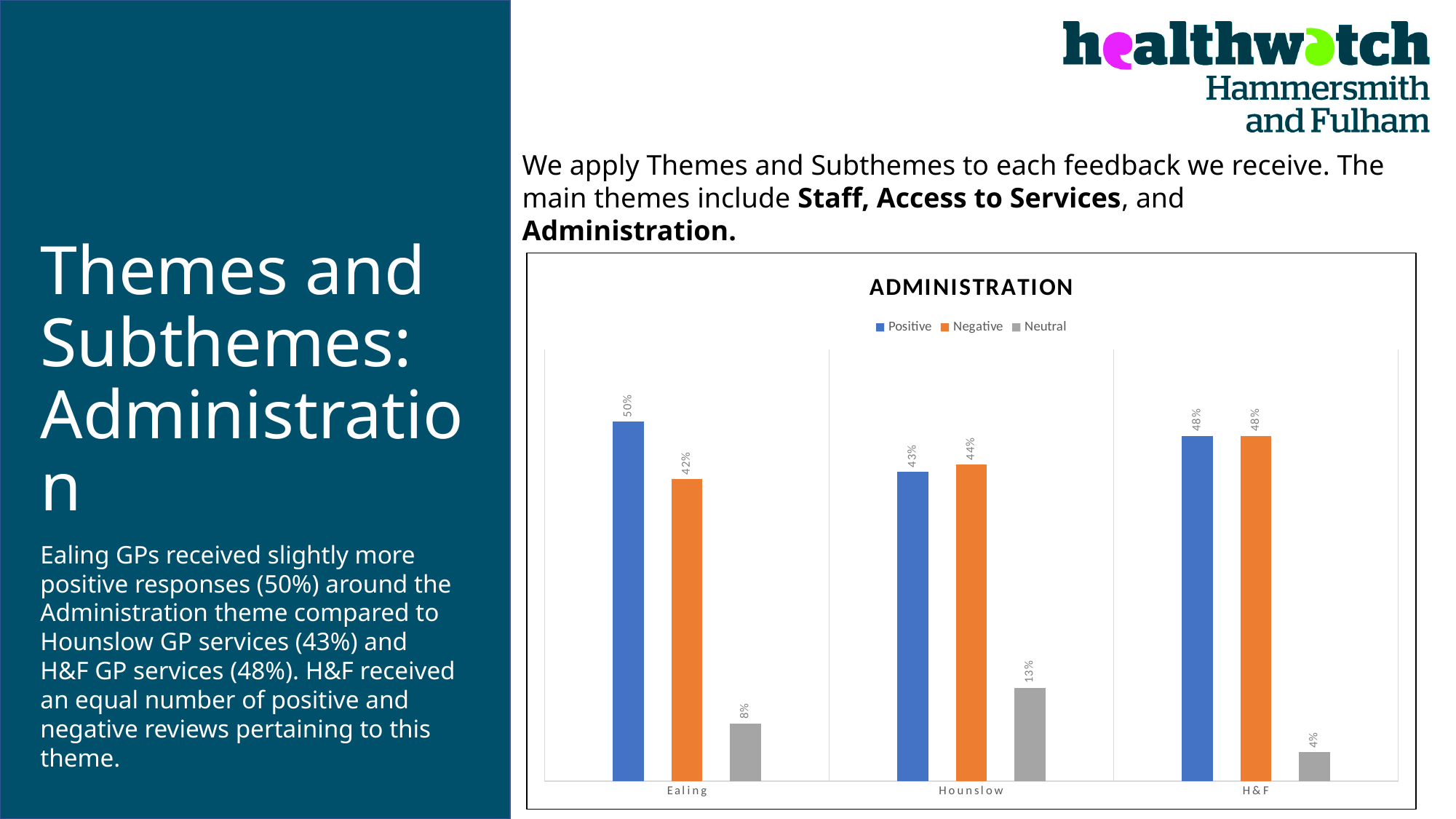
How many series does the legend list? 3 What is the Neutral value for Hounslow? 13% How many categories are shown on the x axis? 3 What is the Positive value for Ealing? 50% What is the Negative value for Hounslow? 44% Which is larger for Hounslow, the Positive value or the Negative value? Negative What is the difference between the Positive and Negative values for Ealing? 8% What kind of chart is shown? Bar chart Which category has the lowest Neutral value? H&F Which category has the highest Positive value? Ealing What is the title of the chart? ADMINISTRATION What is the Neutral value for H&F? 4%